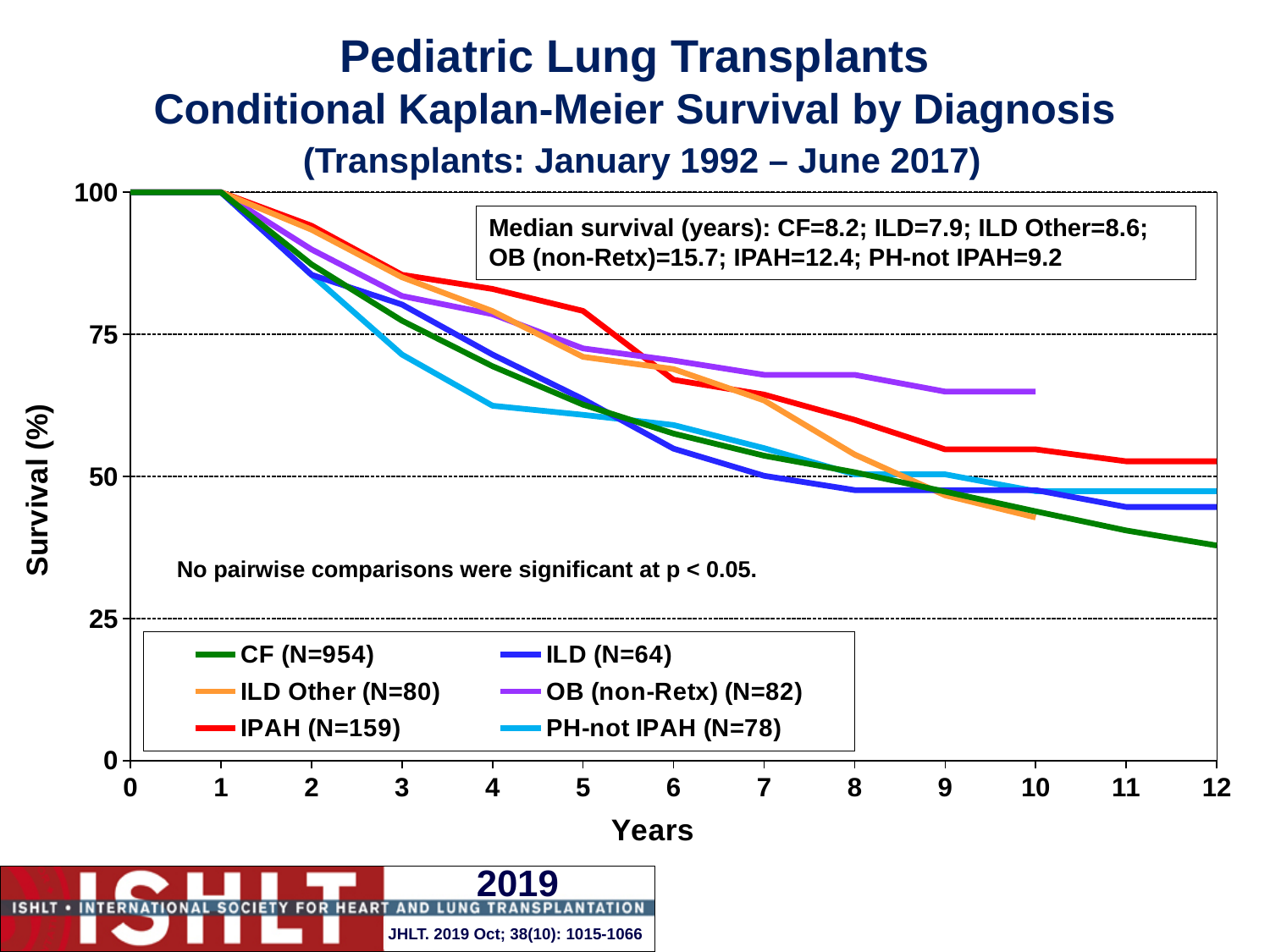
Which diagnosis group has the lowest median survival listed in the text box? ILD What kind of chart is shown on the slide? line chart What is the median survival in years for CF according to the text box? 8.2 Is the survival value for PH-not IPAH at 4 years greater or less than 75? less Is the survival value for CF at 12 years greater or less than 50? less At 10 years, which curve is higher: OB (non-Retx) or CF? OB (non-Retx) What is the difference in median survival (years) between OB (non-Retx) and CF? 7.5 What is the median survival in years for OB (non-Retx) according to the text box? 15.7 What is the N for the CF group shown in the legend? 954 Is the survival value for OB (non-Retx) at 10 years greater or less than 50? greater Which diagnosis group has the highest median survival listed in the text box? OB (non-Retx) How many diagnosis groups does the legend list? 6